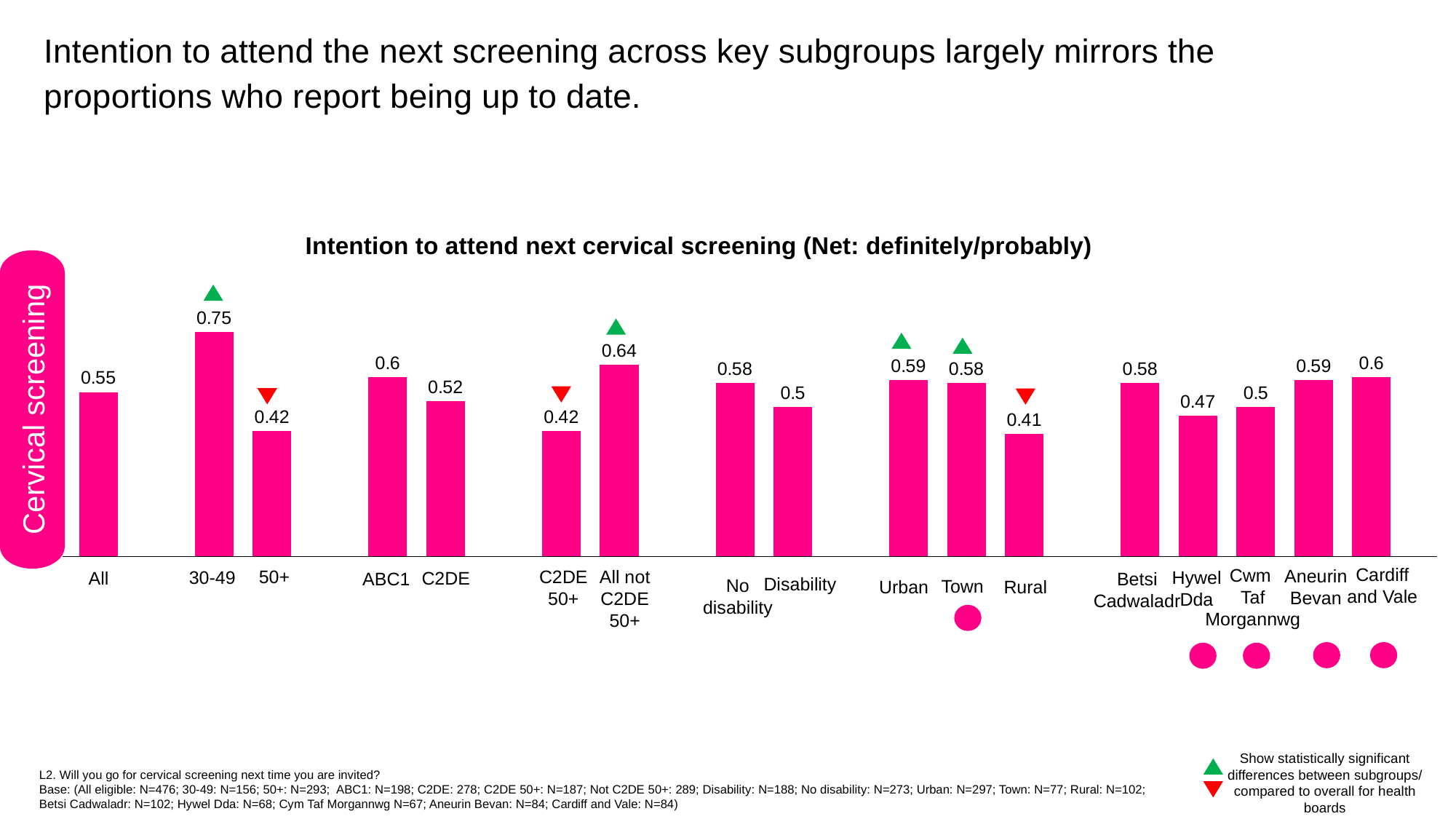
What is the title of the chart? Intention to attend next cervical screening (Net: definitely/probably) How many bars are plotted in the chart? 17 Which category has the highest value? 30-49 What is the value for All not C2DE 50+? 0.64 What is the value for Rural? 0.41 What kind of chart is shown? Bar chart What is the value for Hywel Dda? 0.47 Which is larger, the value for ABC1 or the value for C2DE? ABC1 What is the difference between the values for 30-49 and 50+? 0.33 What is the difference between the values for No disability and Disability? 0.08 What is the value for the 30-49 group? 0.75 Which category has the lowest value? Rural